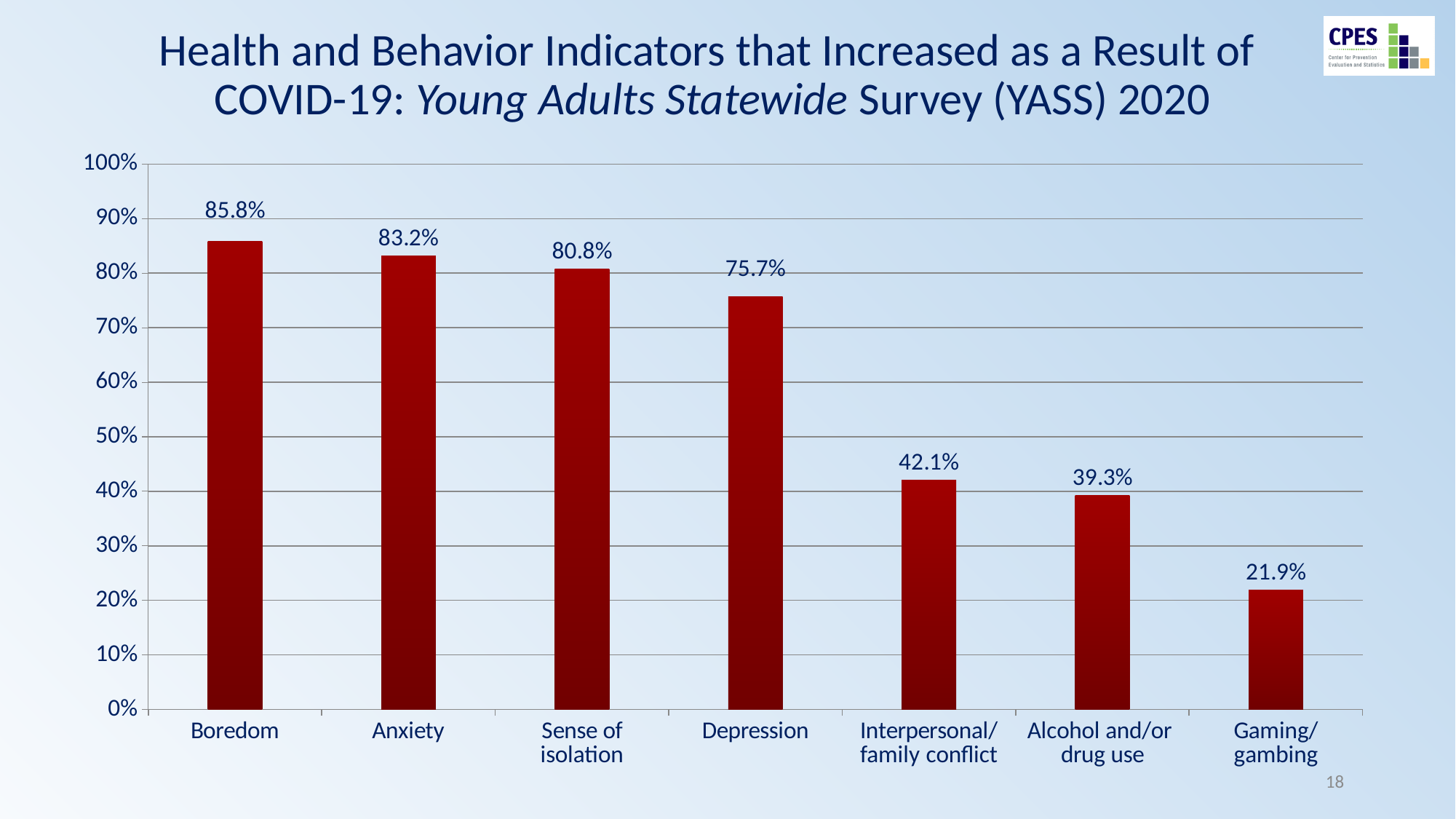
What is the difference between the values for Boredom and Anxiety? 2.6% Which is larger, the value for Sense of isolation or the value for Depression? Sense of isolation How many indicators are shown on the chart? 7 What is the difference between the values for Interpersonal/family conflict and Gaming/gambling? 20.2% Do the values rise or fall from left to right across the chart? Fall What percentage of young adults reported an increase in Boredom? 85.8% Is the value for Interpersonal/family conflict greater or less than 50%? less What is the value shown for Depression? 75.7% Which indicator has the lowest value? Gaming/gambling What kind of chart is shown on the slide? Bar chart What is the value shown for Alcohol and/or drug use? 39.3% Which indicator has the highest value? Boredom